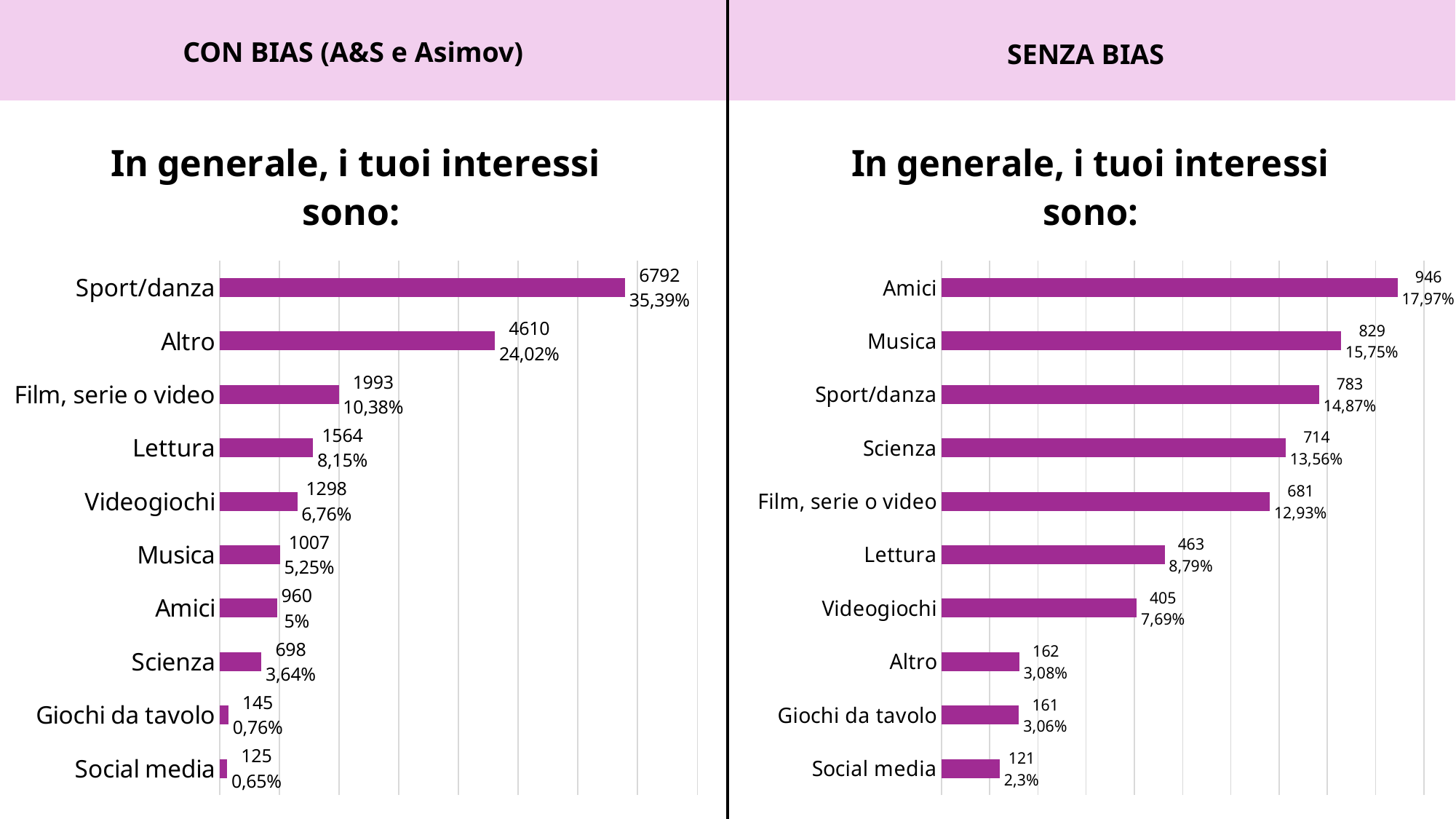
In the right chart (SENZA BIAS), what percentage is shown for Musica? 15,75% What kind of chart is used on the right side (SENZA BIAS)? Bar chart In the left chart (CON BIAS), which is larger, the value for Lettura or the value for Videogiochi? Lettura In the left chart (CON BIAS), what is the difference between the values for Sport/danza and Altro? 2182 What is the title of the chart on the right side of the slide? In generale, i tuoi interessi sono: In the right chart (SENZA BIAS), which category has the highest value? Amici In the right chart (SENZA BIAS), which is larger, the value for Scienza or the value for Lettura? Scienza In the left chart (CON BIAS), what is the value for Giochi da tavolo? 145 In the left chart (CON BIAS), what is the value for Sport/danza? 6792 In the left chart (CON BIAS), which category has the lowest value? Social media How many categories are shown in the left chart (CON BIAS)? 10 In the right chart (SENZA BIAS), what is the difference between the values for Amici and Social media? 825